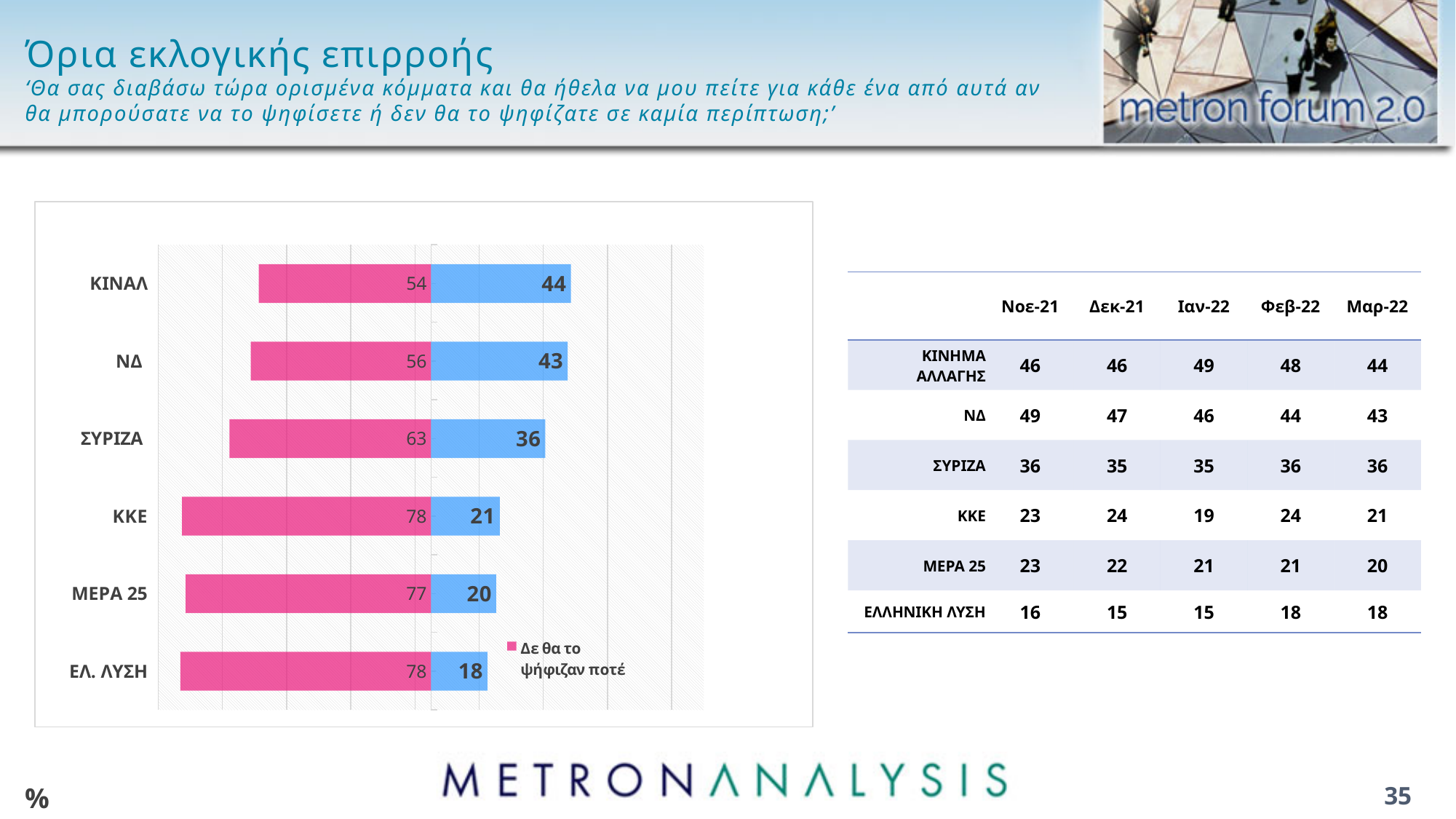
In the bar chart, which party has the lowest blue bar value? ΕΛ. ΛΥΣΗ In the bar chart, what is the value of the blue bar for ΚΙΝΑΛ? 44 In the bar chart, which party has the highest blue bar value? ΚΙΝΑΛ In the bar chart, what is the value of the blue bar for ΚΚΕ? 21 In the bar chart, what is the difference between the pink and blue values for ΝΔ? 13 In the bar chart, what is the value of the pink bar for ΜΕΡΑ 25? 77 What kind of chart is shown on the left of the slide? Bar chart In the bar chart, what is the value of the pink 'Δε θα το ψήφιζαν ποτέ' bar for ΣΥΡΙΖΑ? 63 How many parties are shown in the bar chart? 6 What is the legend entry shown for the pink series in the bar chart? Δε θα το ψήφιζαν ποτέ In the bar chart, which party has the lowest pink 'Δε θα το ψήφιζαν ποτέ' value? ΚΙΝΑΛ In the bar chart, which is larger: the blue value for ΣΥΡΙΖΑ or the blue value for ΚΚΕ? ΣΥΡΙΖΑ